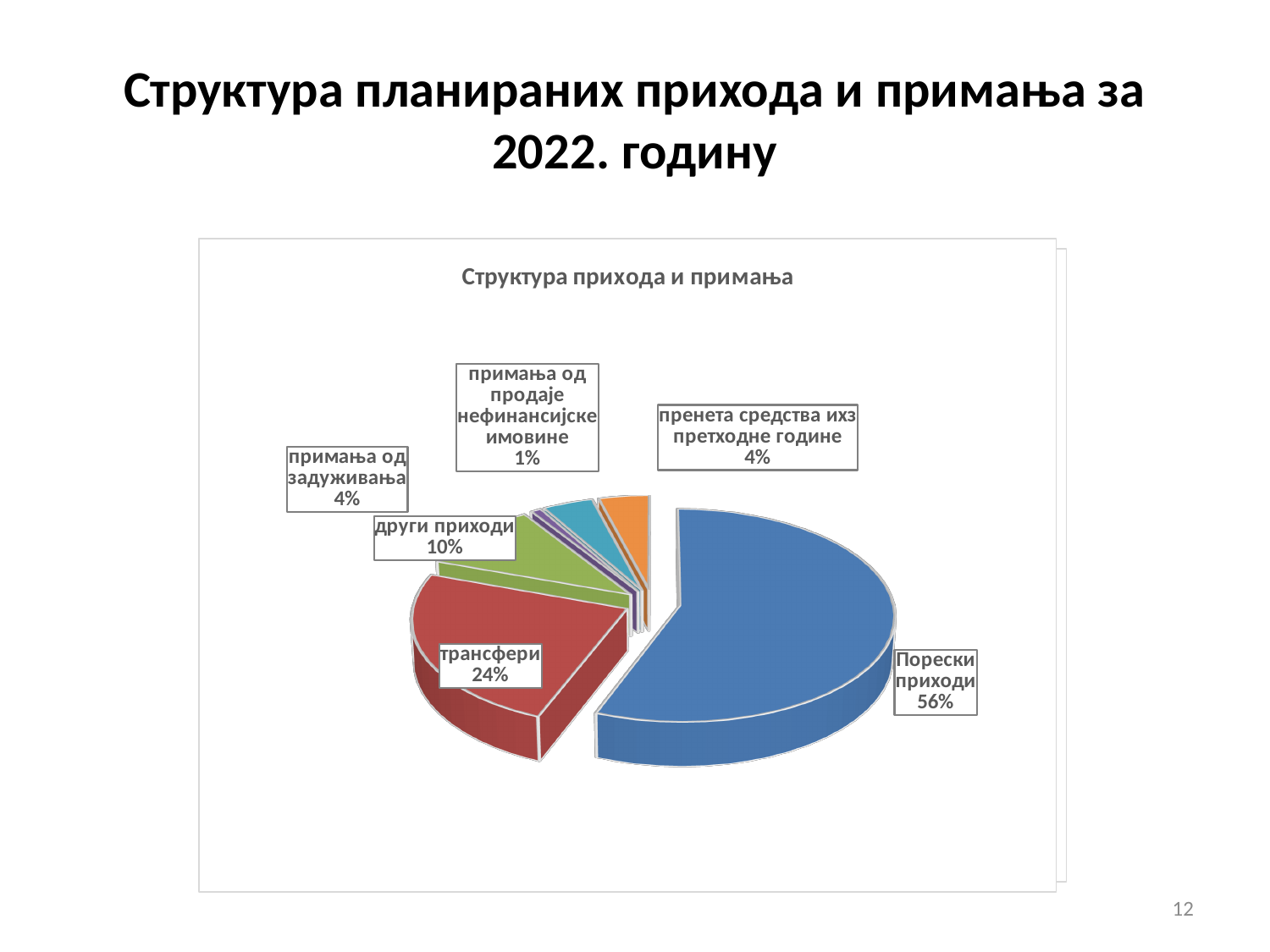
What is the difference in percentage points between Порески приходи and трансфери? 32 What is the chart's title? Структура прихода и примања What share of the pie is labelled Порески приходи? 56% Which slice of the pie is the smallest? примања од продаје нефинансијске имовине What kind of chart is shown on the slide? pie chart What share of the pie is labelled други приходи? 10% How many slices does the pie chart have? 6 What share of the pie is labelled примања од продаје нефинансијске имовине? 1% Which is larger, the share for трансфери or the share for други приходи? трансфери Which slice of the pie is the largest? Порески приходи